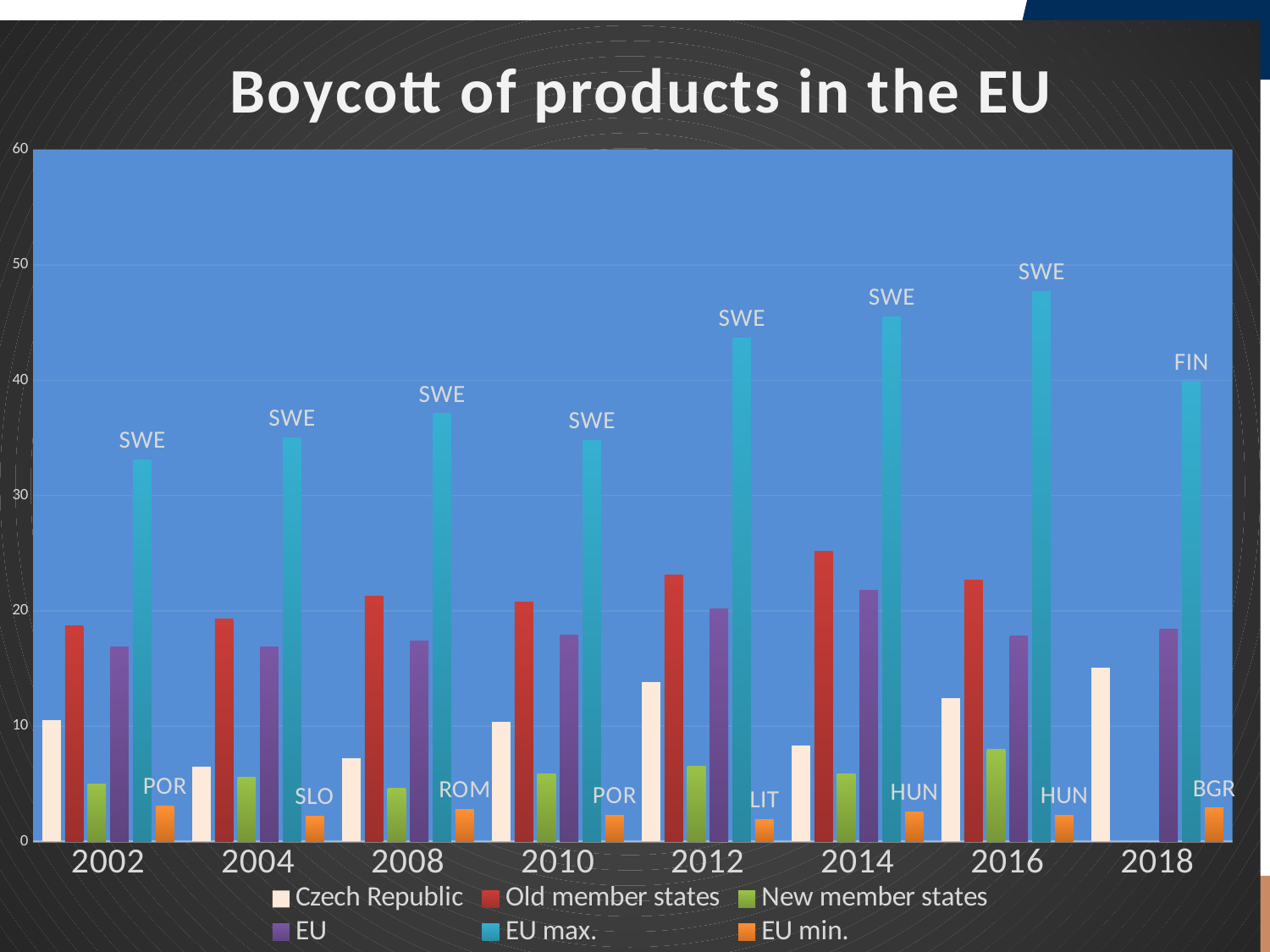
In which year is the EU max. bar the highest? 2016 What is the title of the chart? Boycott of products in the EU How many years are shown on the x axis? 8 In 2012, which is larger: Old member states or EU? Old member states In which year is the Old member states bar the highest? 2014 Is the Czech Republic value for 2012 greater or less than 10? greater Is the Old member states value for 2014 greater or less than 20? greater In which year is the Czech Republic bar the lowest? 2004 Is the EU max. value for 2016 greater or less than 40? greater How many series does the legend list? 6 What kind of chart is shown on the slide? bar chart Which country label is shown above the EU max. bar for 2018? FIN